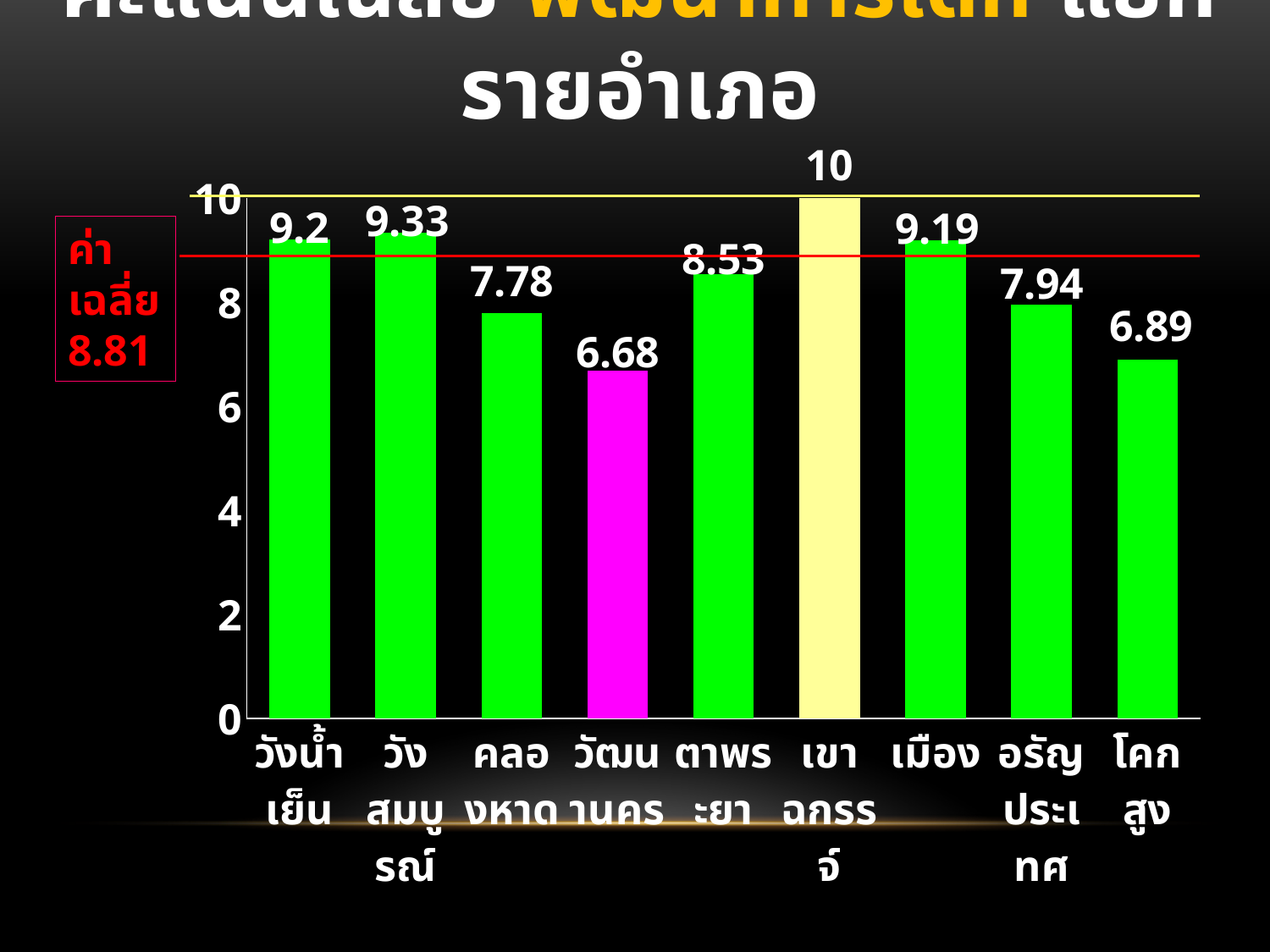
Which district has the highest value? เขาฉกรรจ์ How many districts are shown on the chart? 9 What average value (ค่าเฉลี่ย) is shown in the box on the left of the chart? 8.81 What is the value for วัฒนานคร? 6.68 What is the value for วังน้ำเย็น? 9.2 Which is larger, the value for ตาพระยา or the value for โคกสูง? ตาพระยา Is the value for เมือง greater or less than 8? greater What is the value for อรัญประเทศ? 7.94 What is the difference between the values for วังสมบูรณ์ and คลองหาด? 1.55 Which district has the lowest value? วัฒนานคร What colour is the bar for วัฒนานคร? magenta What kind of chart is shown on the slide? bar chart